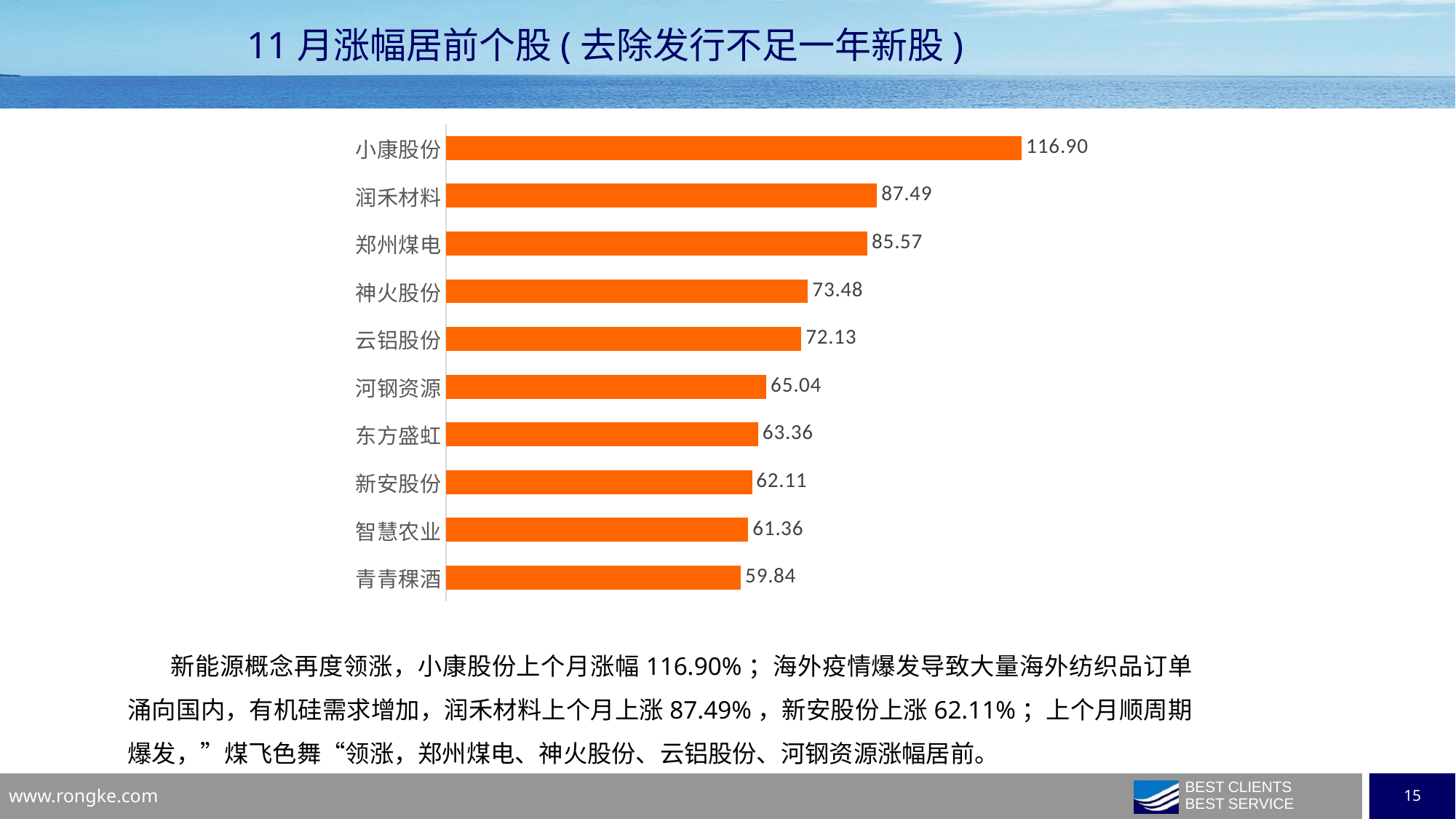
What kind of chart is shown on the slide? bar chart What is the difference between the values for 小康股份 and 润禾材料? 29.41 What is the value for 青青稞酒? 59.84 Which stock has the lowest value in the chart? 青青稞酒 What is the value for 小康股份? 116.90 Which is larger, the value for 河钢资源 or the value for 东方盛虹? 河钢资源 What is the value for 郑州煤电? 85.57 What colour are the bars in the chart? orange What is the difference between the values for 神火股份 and 云铝股份? 1.35 How many stocks are shown in the chart? 10 What is the value for 新安股份? 62.11 Which stock has the highest value in the chart? 小康股份